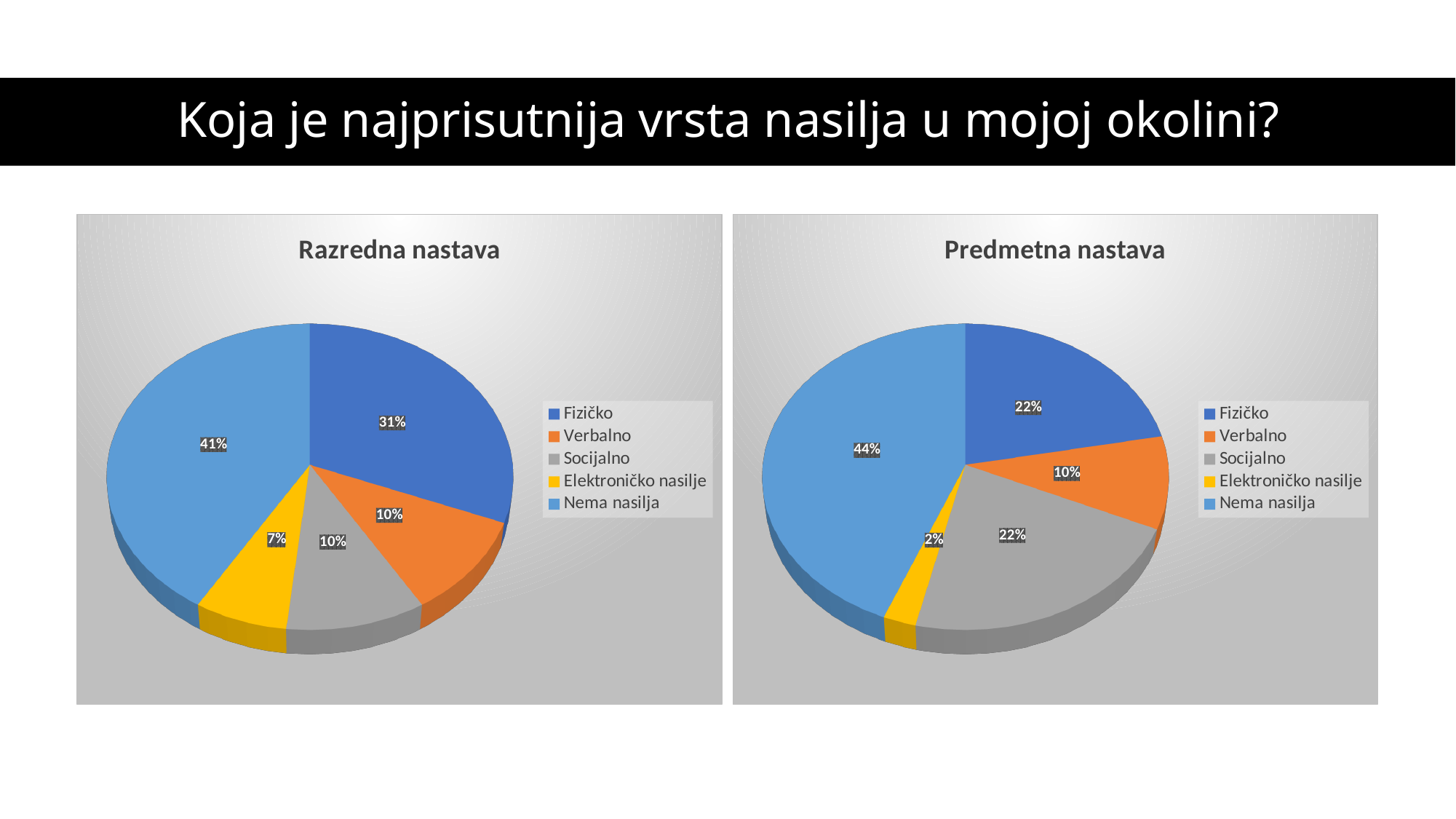
In the 'Predmetna nastava' chart, what is the difference between the shares of Nema nasilja and Elektroničko nasilje? 42% In the 'Razredna nastava' chart, which category has the largest slice? Nema nasilja In the 'Predmetna nastava' chart, what share does Socijalno have? 22% In the 'Razredna nastava' chart, what share does Nema nasilja have? 41% What kind of chart is 'Predmetna nastava'? Pie chart In the 'Predmetna nastava' chart, which category has the largest slice? Nema nasilja In the 'Razredna nastava' chart, what is the difference between the shares of Nema nasilja and Fizičko? 10% How many categories does the legend of the 'Razredna nastava' chart list? 5 In the 'Razredna nastava' chart, which category has the smallest slice? Elektroničko nasilje In the 'Predmetna nastava' chart, which is larger, Verbalno or Socijalno? Socijalno In the 'Razredna nastava' chart, what share does Fizičko have? 31% In the 'Predmetna nastava' chart, what share does Elektroničko nasilje have? 2%